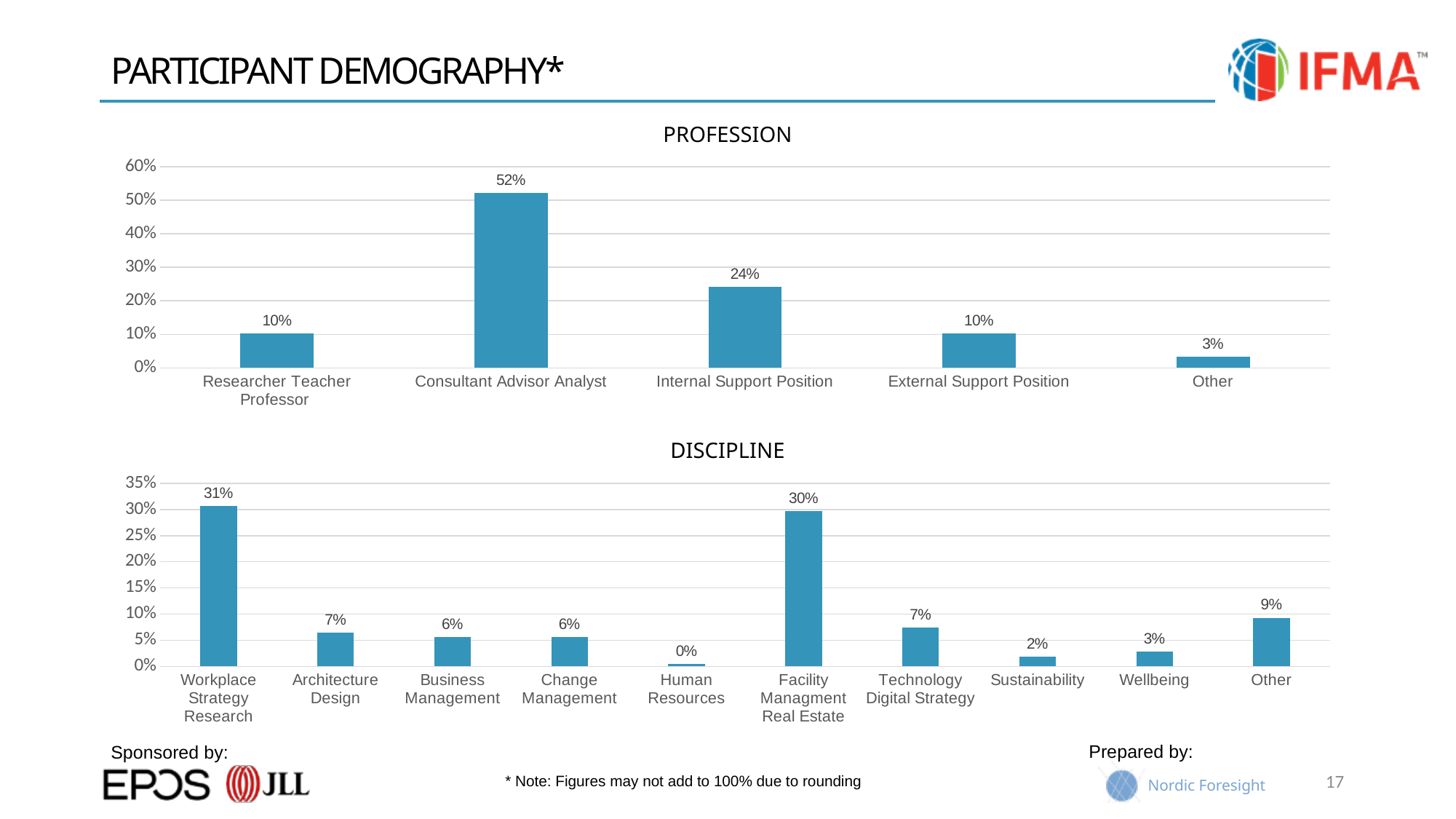
In the PROFESSION chart, what is the value for Consultant Advisor Analyst? 52% In the DISCIPLINE chart, which category has the lowest value? Human Resources In the DISCIPLINE chart, how many categories are shown? 10 In the DISCIPLINE chart, which category has the highest value? Workplace Strategy Research In the PROFESSION chart, which category has the lowest value? Other In the PROFESSION chart, how many categories are shown? 5 What type of chart is the DISCIPLINE chart? Bar chart In the PROFESSION chart, what is the difference between Consultant Advisor Analyst and Internal Support Position? 28% In the DISCIPLINE chart, what is the difference between Other and Wellbeing? 6% In the DISCIPLINE chart, what is the value for Facility Managment Real Estate? 30% In the DISCIPLINE chart, which is larger, Other or Architecture Design? Other In the PROFESSION chart, is the value for Internal Support Position greater or less than 20%? greater